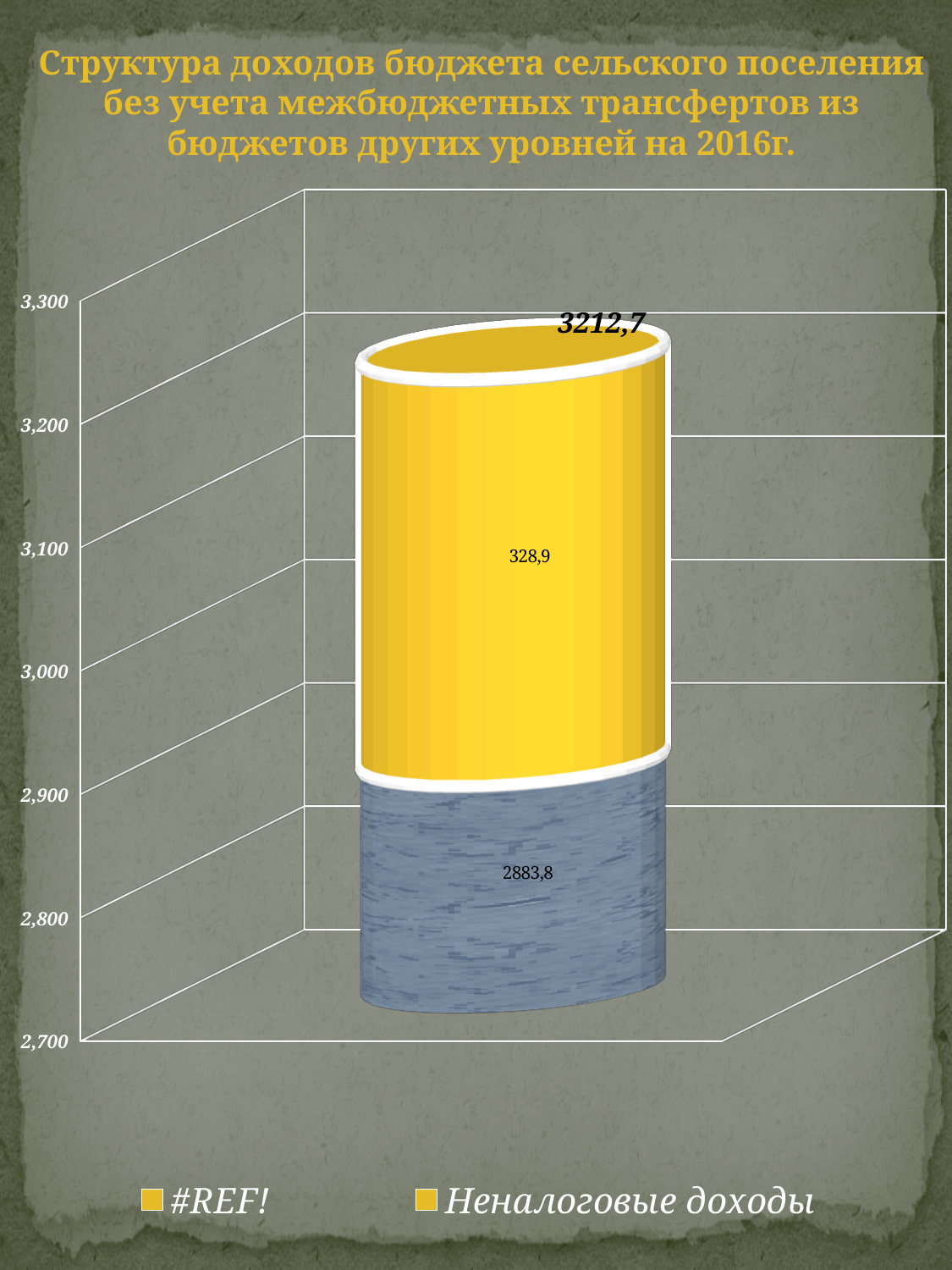
What are the two entries shown in the legend? #REF! and Неналоговые доходы What is the difference between the gray segment (2883,8) and the yellow segment (328,9)? 2554,9 What kind of chart is shown on the slide? Stacked bar chart Which segment of the bar has the larger value, the gray bottom segment or the yellow top segment? The gray bottom segment How many entries does the legend list? 2 What value is printed on the gray bottom segment of the bar? 2883,8 How many stacked bars are plotted in the chart? 1 What is the lowest value shown on the vertical axis? 2,700 What value is printed on the yellow top segment of the bar? 328,9 What is the total value printed above the stacked bar? 3212,7 Which segment of the stacked bar is the smallest? The yellow top segment (328,9)